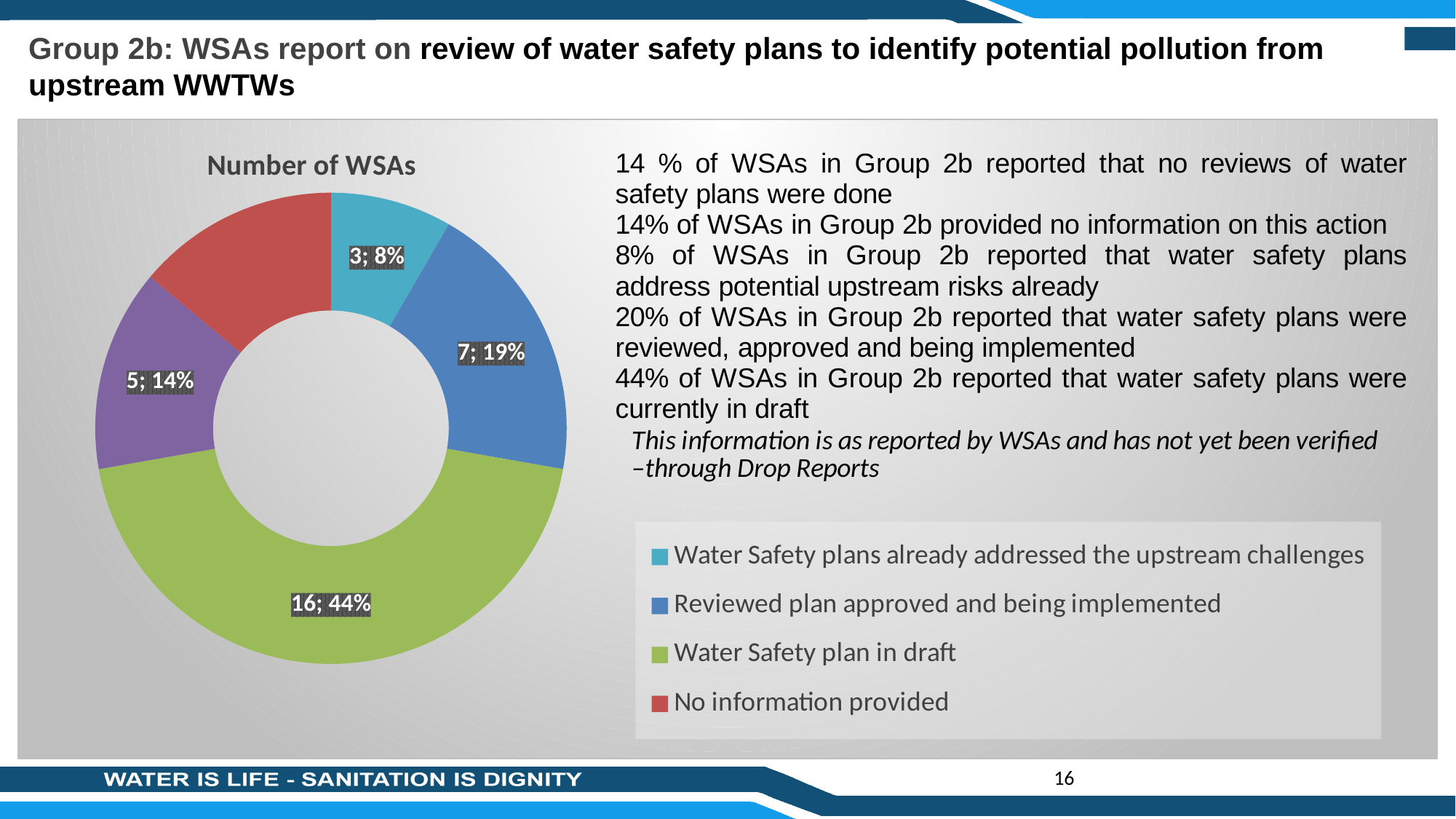
What is the difference in the number of WSAs between 'Water Safety plan in draft' and 'Reviewed plan approved and being implemented'? 9 Which category has the smallest slice in the chart? Water Safety plans already addressed the upstream challenges How many WSAs are in the 'Water Safety plan in draft' category? 16 What kind of chart is shown on the slide? doughnut chart What share of the chart does 'Water Safety plan in draft' represent? 44% How many entries does the chart legend list? 4 Which is larger: the slice for 'Reviewed plan approved and being implemented' or the slice for 'Water Safety plans already addressed the upstream challenges'? Reviewed plan approved and being implemented How many WSAs are in the 'Reviewed plan approved and being implemented' category? 7 How many slices does the doughnut chart have? 5 What is the title of the chart? Number of WSAs Which category has the largest slice in the chart? Water Safety plan in draft What percentage is shown for 'Water Safety plans already addressed the upstream challenges'? 8%